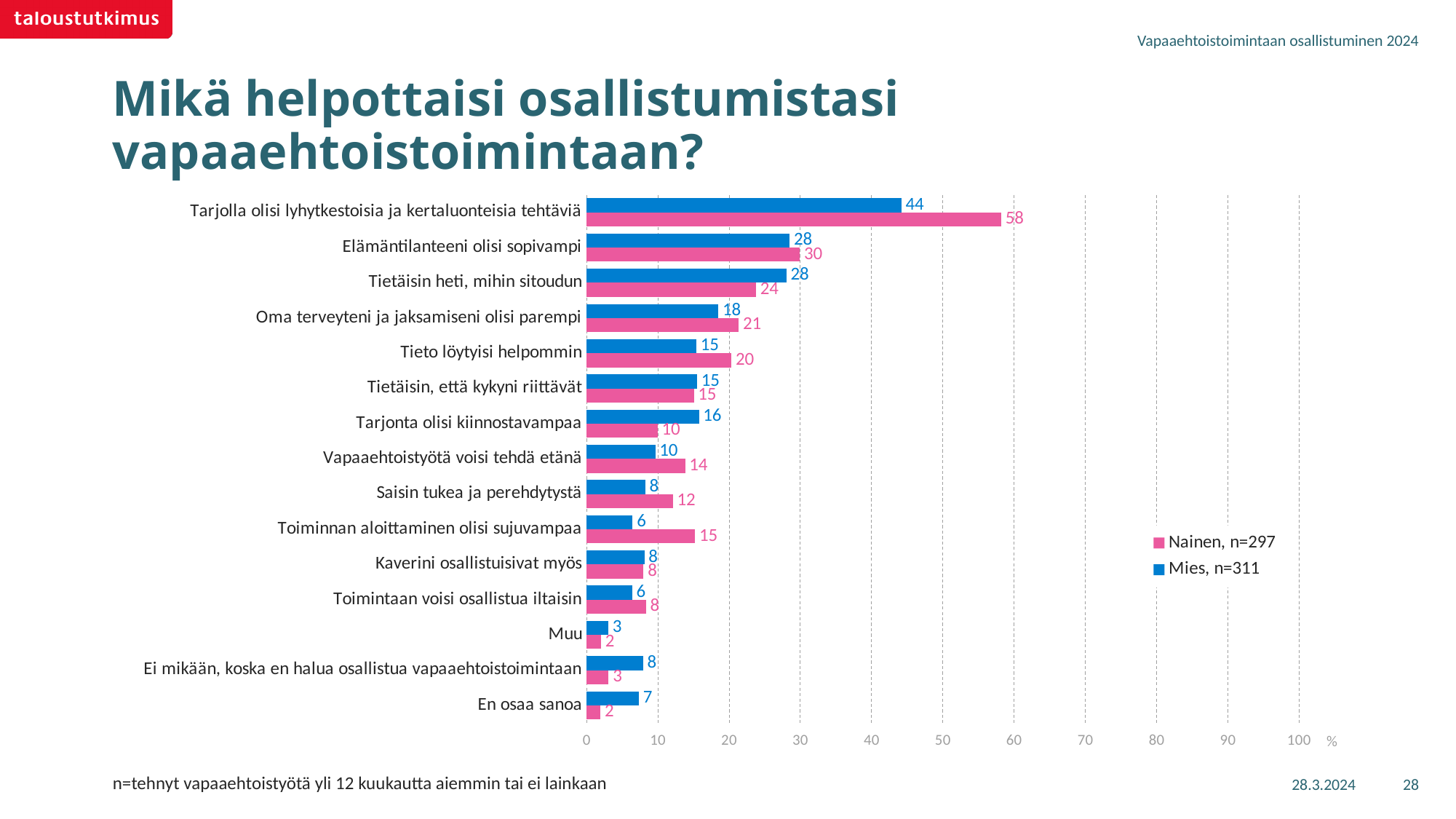
For "Tarjonta olisi kiinnostavampaa", which is larger, the Mies value or the Nainen value? Mies Is the Nainen value for "Elämäntilanteeni olisi sopivampi" greater or less than 20? greater Which category has the highest value for Mies? Tarjolla olisi lyhytkestoisia ja kertaluonteisia tehtäviä What is the difference between the Nainen and Mies values for "Tarjolla olisi lyhytkestoisia ja kertaluonteisia tehtäviä"? 14 What is the value for Nainen for "Tarjolla olisi lyhytkestoisia ja kertaluonteisia tehtäviä"? 58 Which colour represents the Nainen series in the chart? Pink What is the value for Nainen for "Toiminnan aloittaminen olisi sujuvampaa"? 15 What kind of chart is shown on the slide? Bar chart What is the value for Mies for "Tietäisin heti, mihin sitoudun"? 28 How many series does the legend list? 2 Which category has the lowest value for Nainen? Muu and En osaa sanoa (both 2) How many categories are shown on the chart? 15